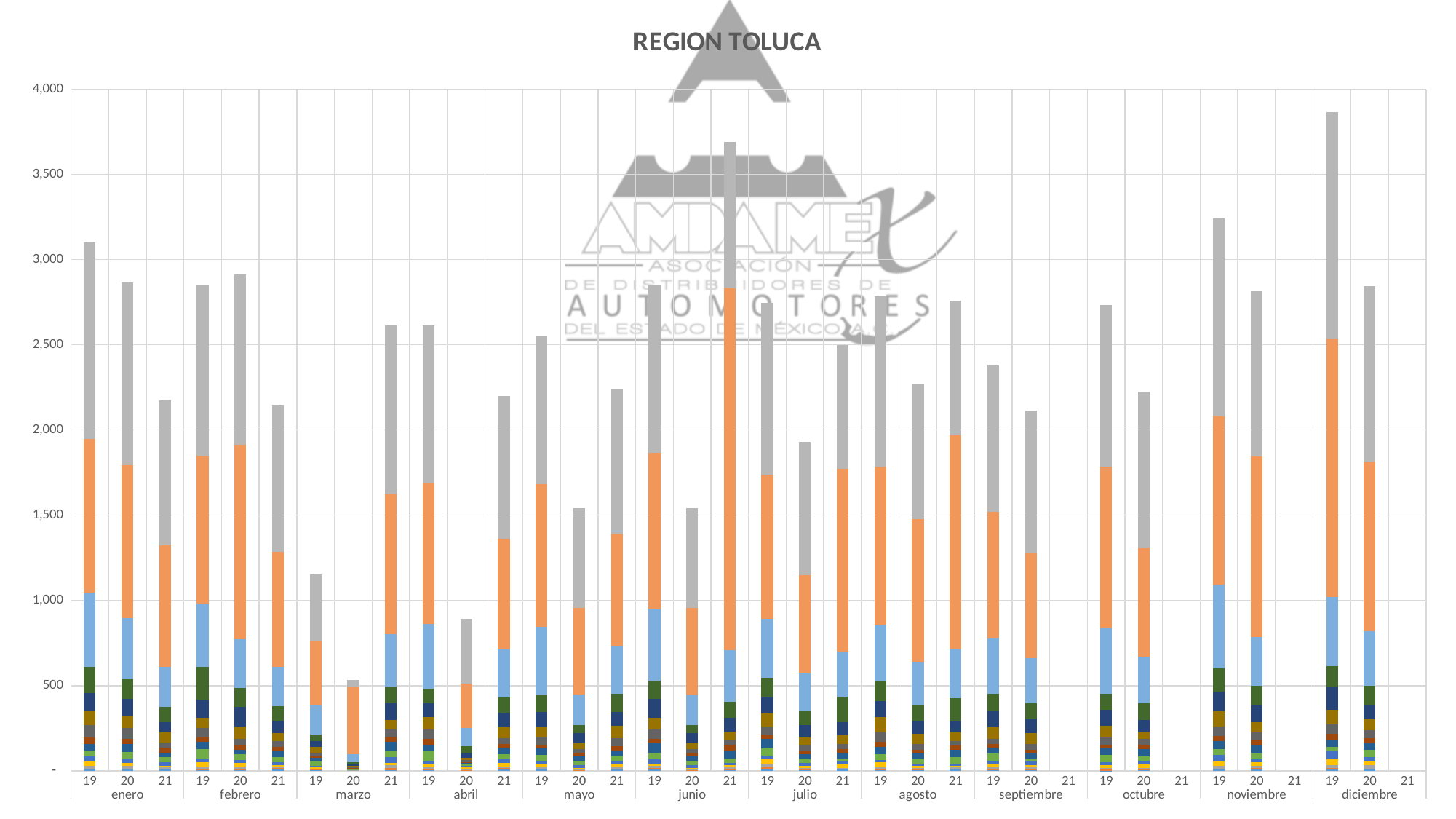
Is the total for agosto 21 greater or less than 2,500? greater How many months are shown along the x axis? 12 What is the title of the chart? REGION TOLUCA Which has the taller stacked bar, junio 20 or junio 21? junio 21 Is the total for noviembre 19 greater or less than 3,000? greater Which month and year has the shortest stacked bar? marzo 20 Which month and year has the tallest stacked bar? diciembre 19 Is the total for marzo 19 greater or less than 1,000? greater What kind of chart is shown on the slide? bar chart Which has the taller stacked bar, enero 19 or enero 21? enero 19